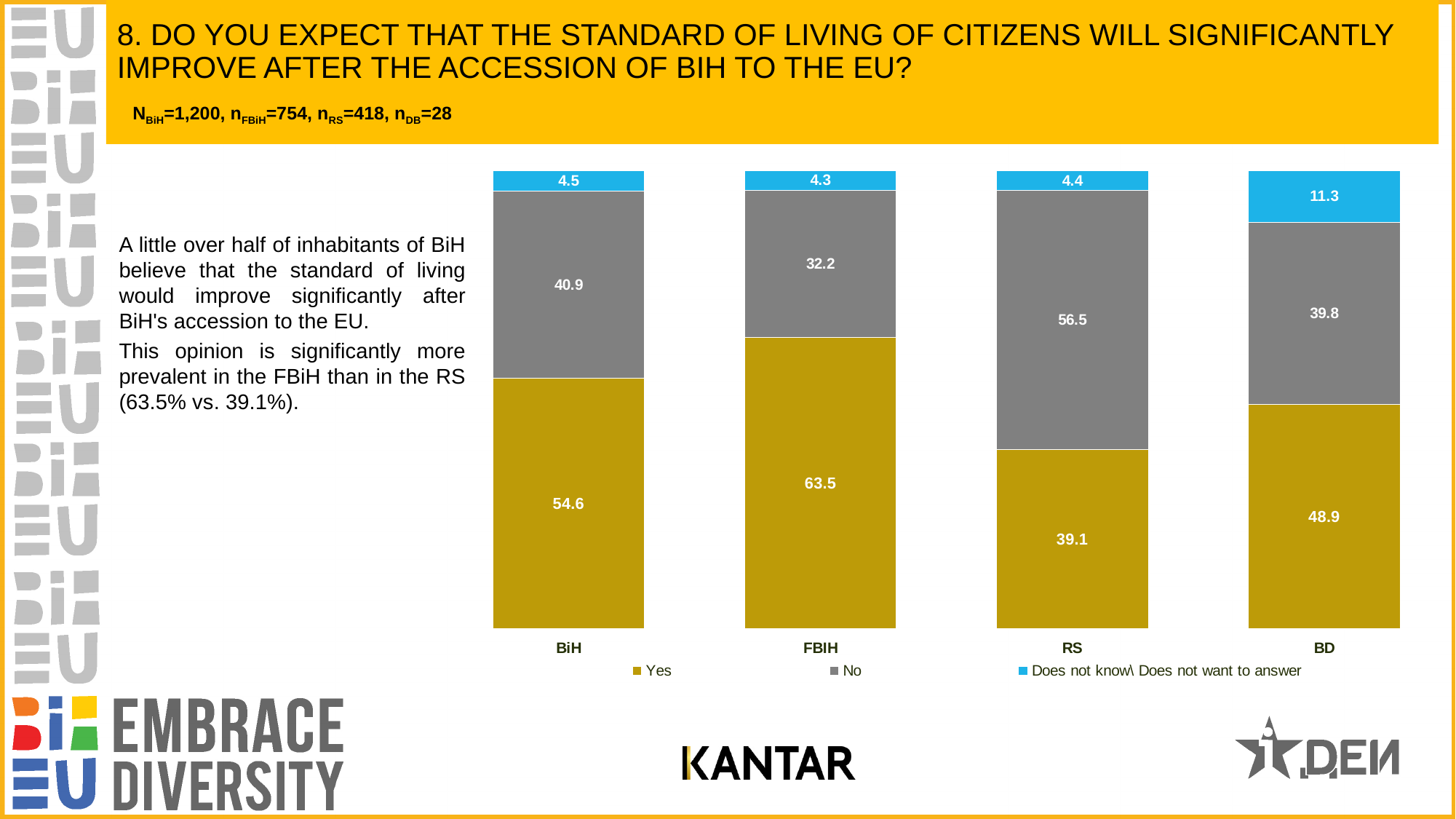
What is the total of the stacked bar for FBIH? 100 Which series is shown in blue in the legend? Does not know\ Does not want to answer What is the value for "No" in the RS bar? 56.5 What is the difference between the "Yes" values for FBIH and RS? 24.4 What is the value for "Does not know\ Does not want to answer" in the BD bar? 11.3 What is the value for "Yes" in the BiH bar? 54.6 Which category has the lowest "Yes" value? RS How many series does the legend list? 3 Which is larger, the "No" value for BiH or the "No" value for BD? BiH What kind of chart is shown on the slide? Stacked bar chart Which category has the highest "Yes" value? FBIH How many categories are shown on the x axis? 4